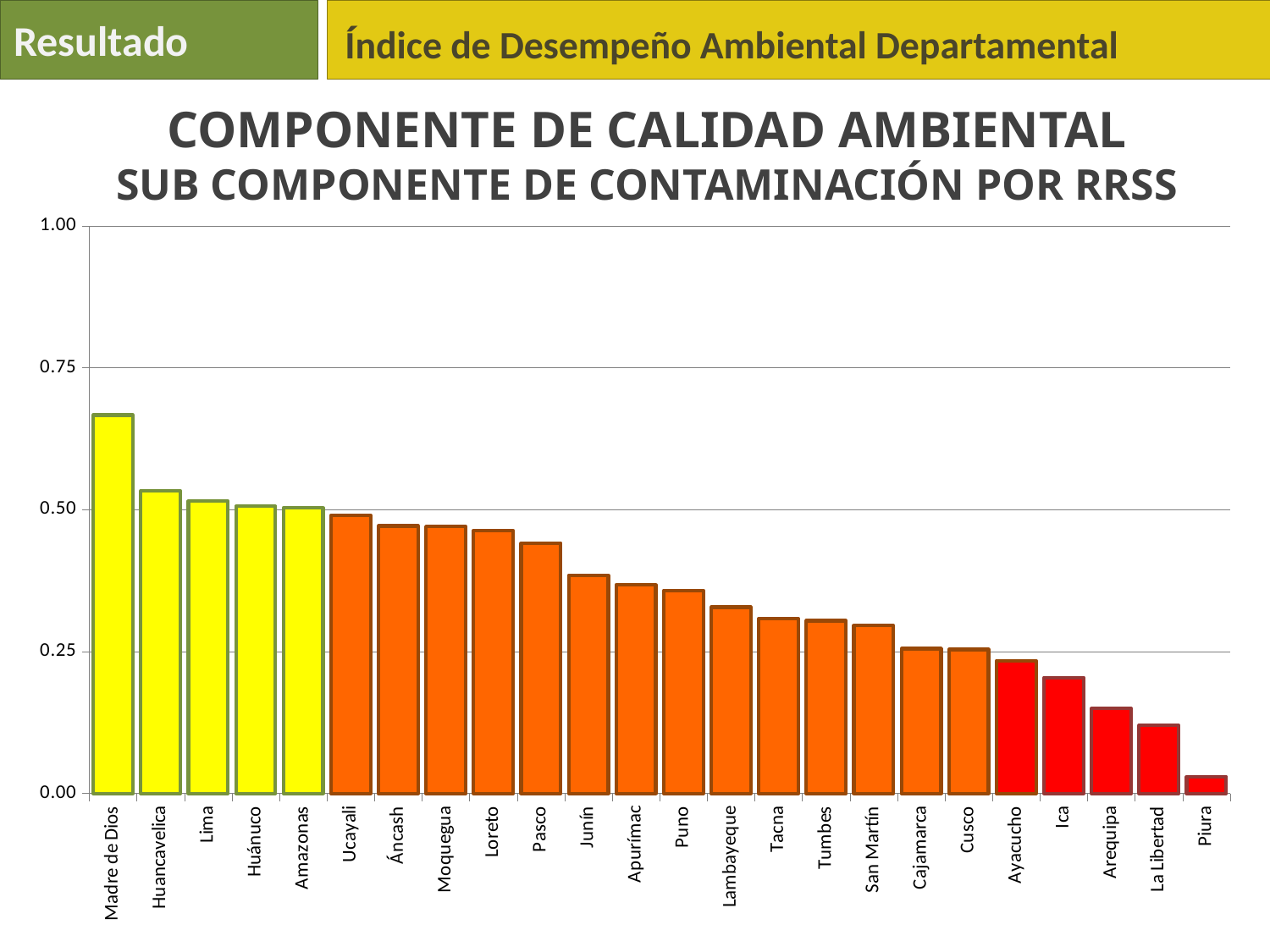
Is the value for Ica greater or less than 0.25? less Is the value for Madre de Dios greater or less than 0.50? greater Is the value for Lambayeque greater or less than 0.25? greater How many departments are shown on the x axis of the chart? 24 Which department has the highest value in the chart? Madre de Dios Which department has the lowest value in the chart? Piura What kind of chart is shown on the slide? bar chart Which has a larger value, Lima or Cusco? Lima Do the values rise or fall moving from left to right along the x axis? fall What colour are the bars for the five leftmost departments (Madre de Dios to Amazonas)? yellow